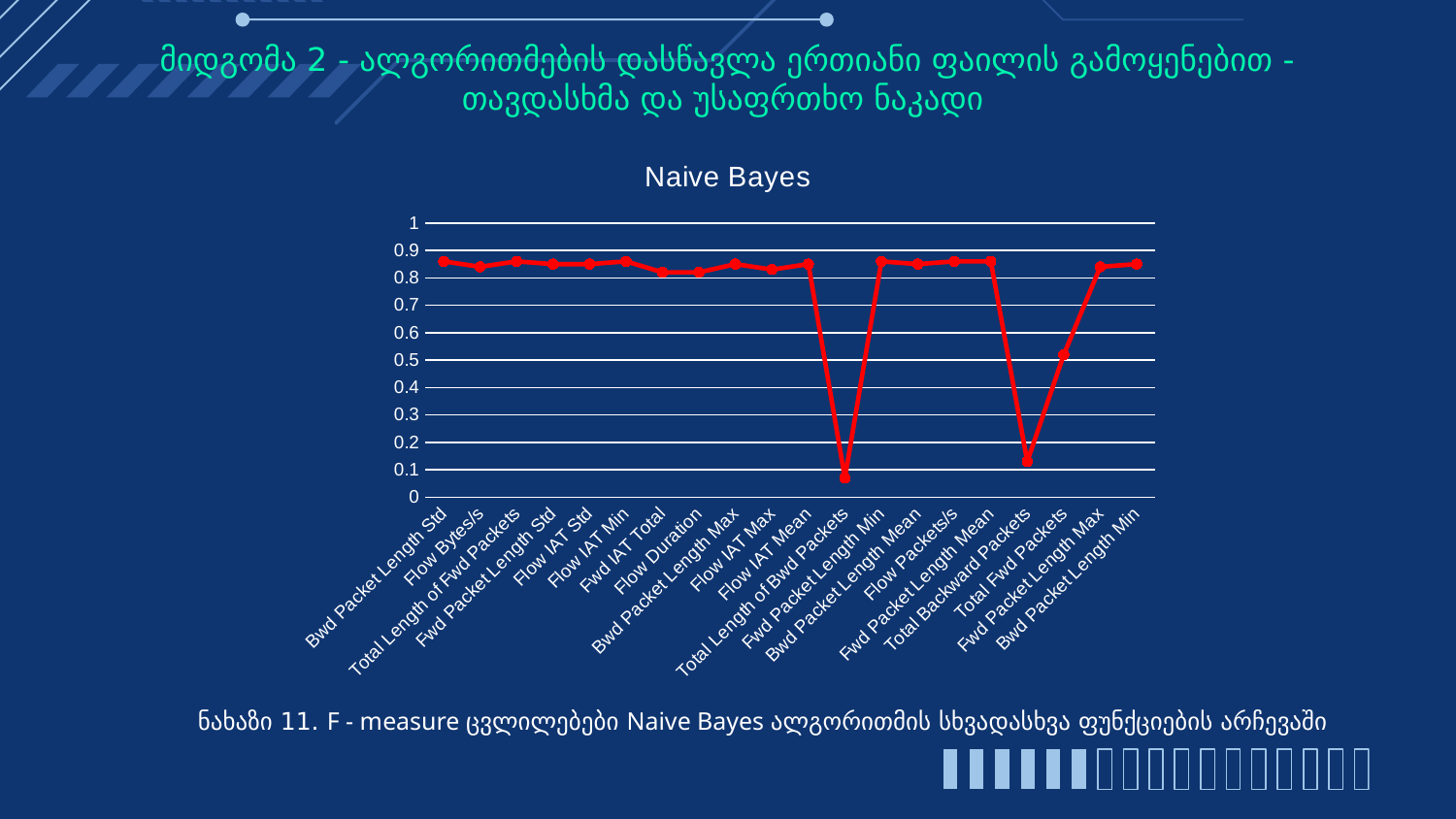
Which is larger, the value for Total Backward Packets or the value for Total Fwd Packets? Total Fwd Packets What is the title of the chart? Naive Bayes Which category has the lowest value in the chart? Total Length of Bwd Packets Is the value for Flow Bytes/s greater or less than 0.7? greater Is the value for Flow Duration greater or less than 0.6? greater How many categories are plotted along the x axis of the chart? 20 What type of chart is shown on the slide? line chart What colour is the line in the chart? red Is the value for Total Backward Packets greater or less than 0.2? less Which is larger, the value for Flow IAT Mean or the value for Total Length of Bwd Packets? Flow IAT Mean